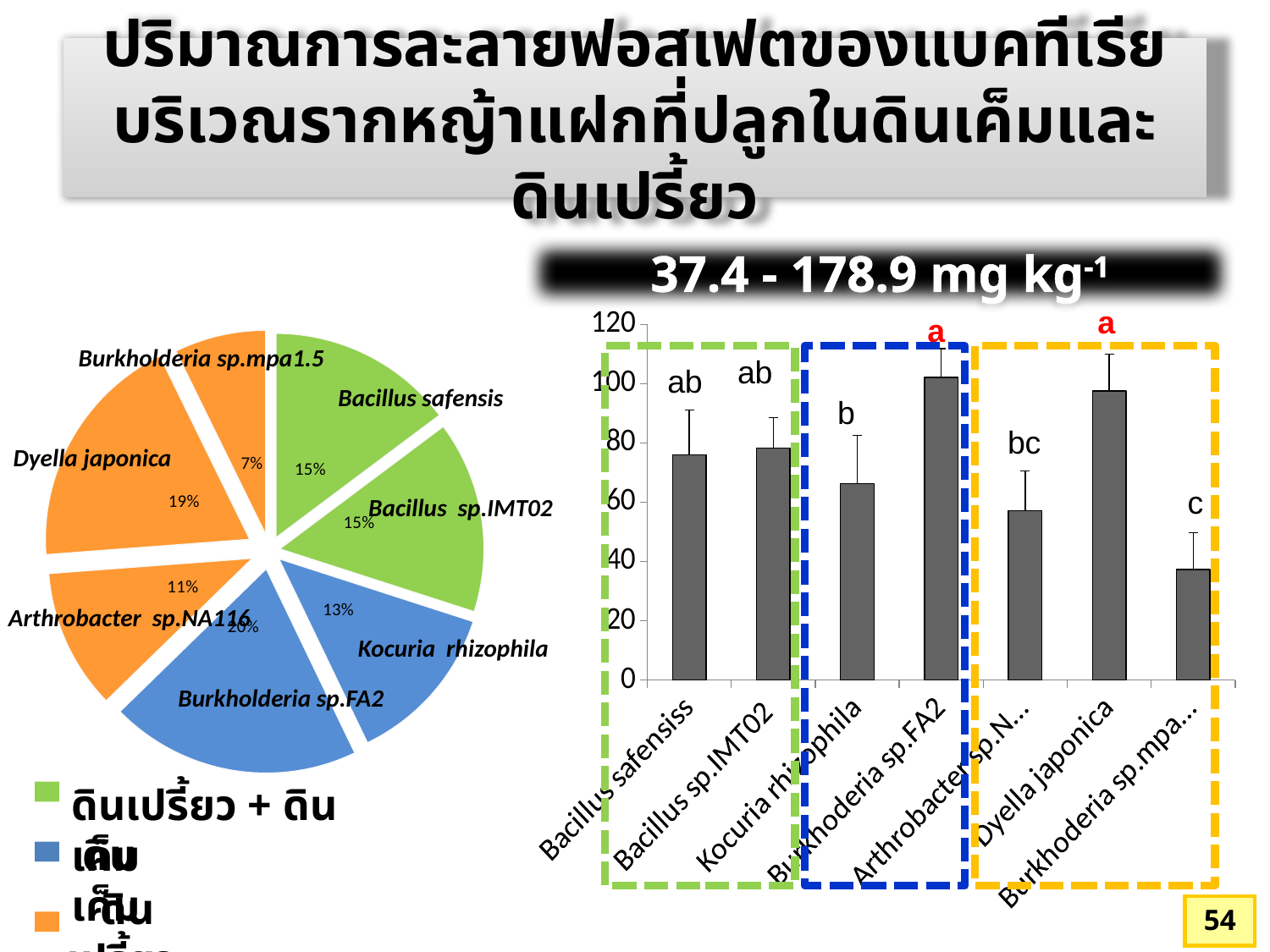
In the pie chart, which bacterium has the largest slice? Burkholderia sp.FA2 What kind of chart is the chart on the left of the slide? Pie chart In the pie chart, what percentage is shown for Dyella japonica? 19% In the bar chart on the right, which bar is taller: Kocuria rhizophila or Burkholderia sp.FA2? Burkholderia sp.FA2 How many slices does the pie chart have? 7 In the bar chart on the right, which bacterium has the lowest bar? Burkholderia sp.mpa1.5 In the pie chart, what is the difference in percentage points between the Burkholderia sp.FA2 slice and the Burkholderia sp.mpa1.5 slice? 13 What kind of chart is the chart on the right of the slide? Bar chart In the pie chart, which bacterium has the smallest slice? Burkholderia sp.mpa1.5 In the pie chart, what percentage is shown for Burkholderia sp.FA2? 20% In the pie chart, what percentage is shown for Kocuria rhizophila? 13% In the bar chart on the right, is the value for Burkholderia sp.FA2 greater or less than 80? greater